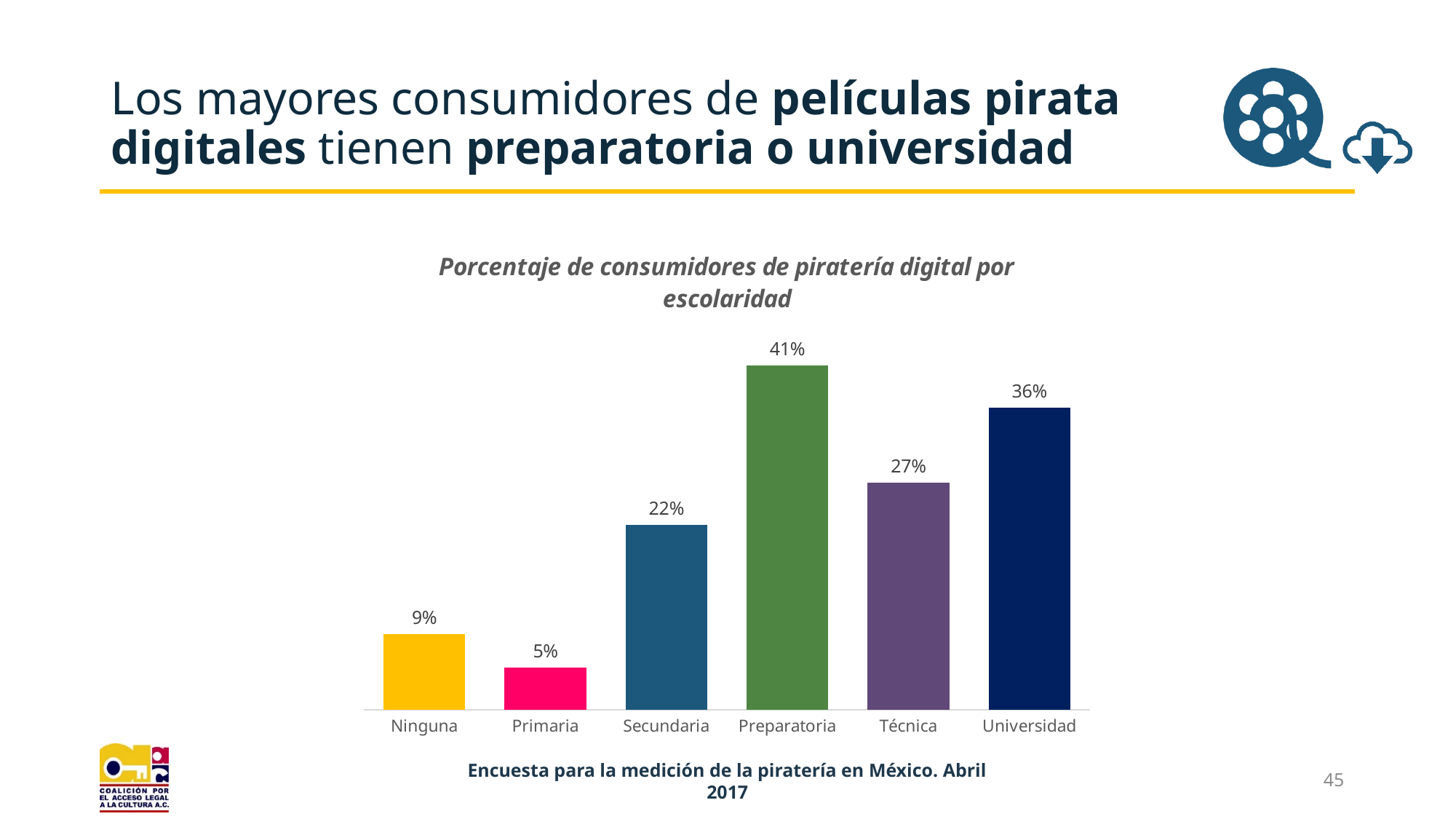
How many categories are shown on the x axis? 6 What colour is the bar for Preparatoria? Green What is the value for Técnica? 27% What is the value for Preparatoria? 41% Which category has the highest value? Preparatoria What is the difference between the values for Secundaria and Primaria? 17% What kind of chart is shown on the slide? Bar chart Which is larger, the value for Universidad or the value for Técnica? Universidad What is the difference between the values for Preparatoria and Universidad? 5% What is the title of the chart? Porcentaje de consumidores de piratería digital por escolaridad What is the value for Ninguna? 9% Which category has the lowest value? Primaria